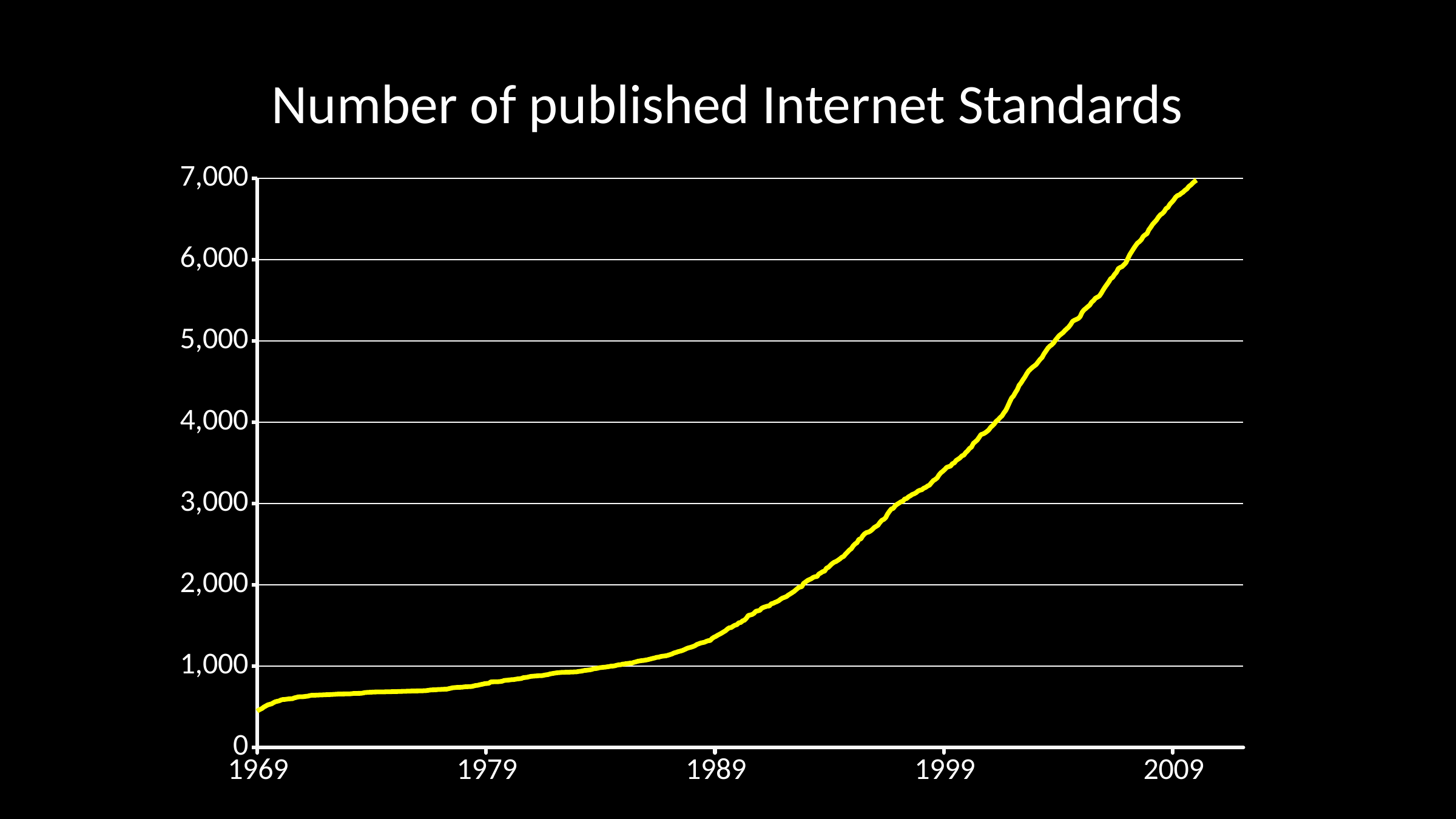
Is the value for 1999 greater or less than 2,000? greater What is the highest value shown on the vertical axis? 7,000 Is the value for 1989 greater or less than 1,000? greater What is the first year labelled on the horizontal axis? 1969 Is the value for 1969 greater or less than 1,000? less Which year has the higher value, 1979 or 1999? 1999 Do the values rise or fall from 1969 to 2009? rise What kind of chart is shown on the slide? line chart What is the title of the chart? Number of published Internet Standards